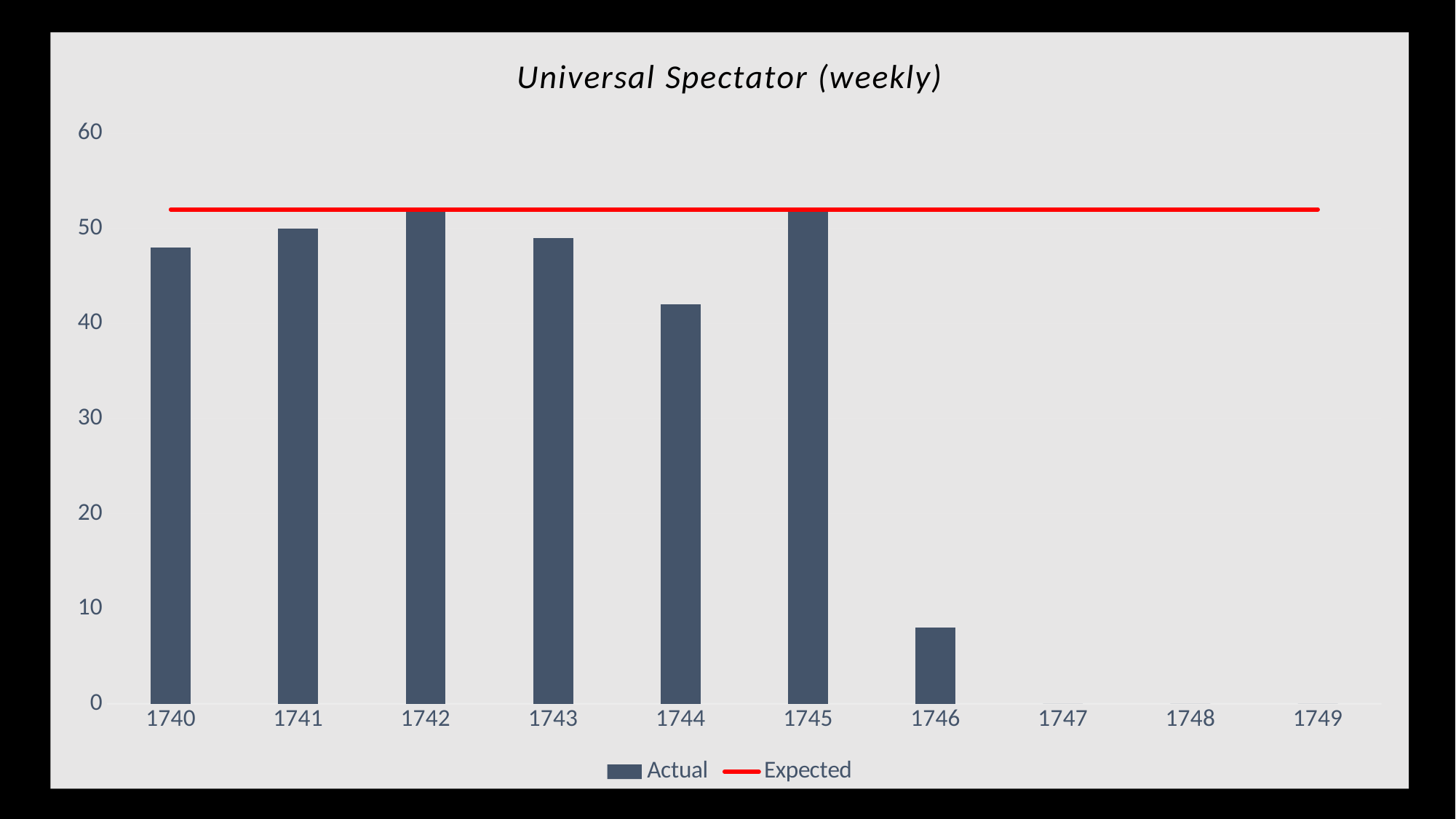
Is the Actual value for 1744 greater or less than 40? greater Which year has the lowest Actual bar among the years with a visible bar? 1746 Which year has the larger Actual value, 1743 or 1744? 1743 What type of chart is shown on the slide? combination bar and line chart How many years are labelled along the x axis? 10 Is the Actual value for 1740 greater or less than 50? less Is the Expected line greater or less than 50? greater Does the Actual value rise or fall from 1745 to 1746? fall What is the title of the chart? Universal Spectator (weekly) How many series does the legend list? 2 What colour is the Expected line? red